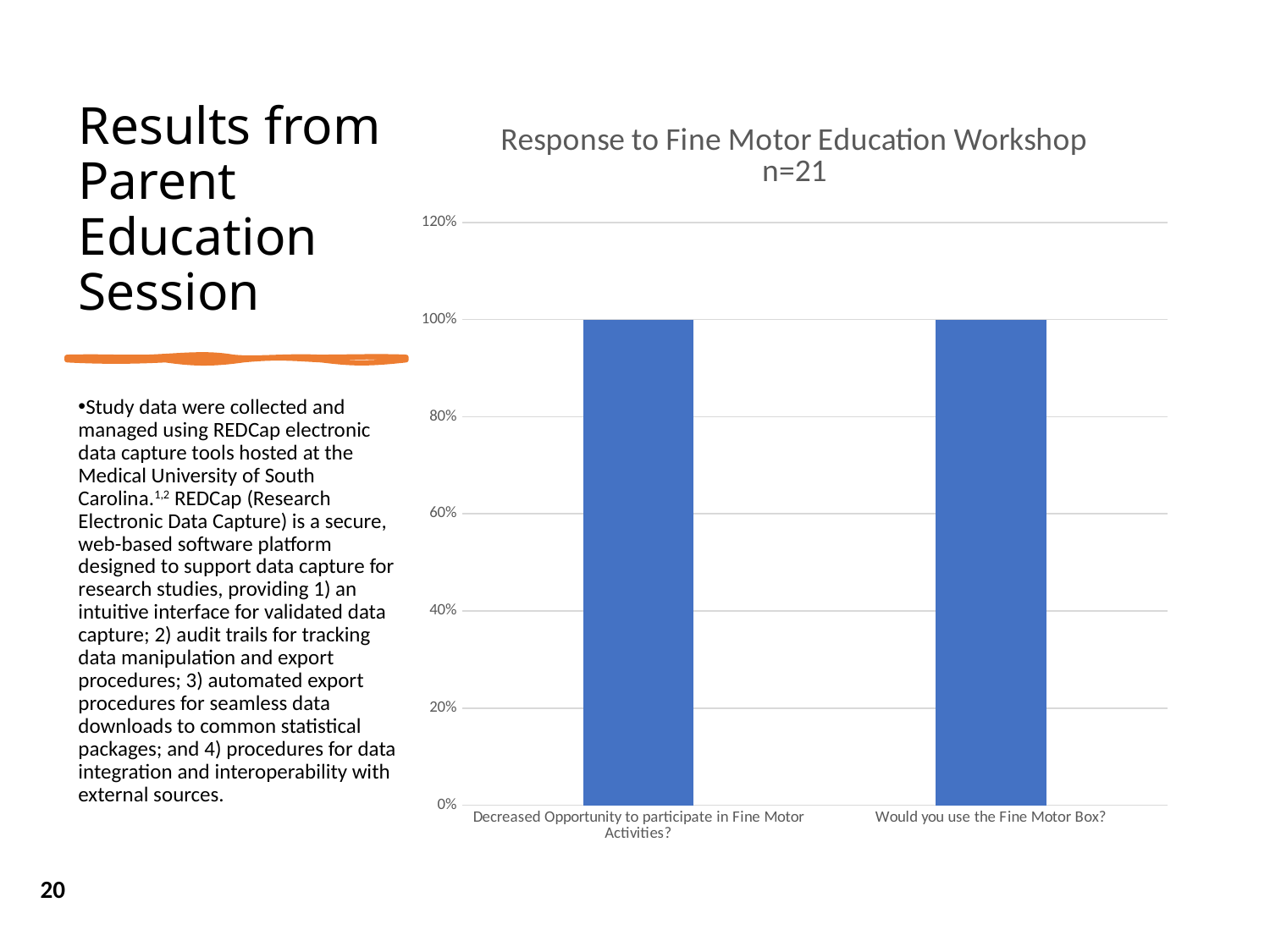
What sample size (n) is stated in the chart title? n=21 What is the highest value shown on the chart's y axis? 120% What kind of chart is shown on the slide? bar chart Is the value for "Decreased Opportunity to participate in Fine Motor Activities?" greater or less than 60%? greater Is the value for "Would you use the Fine Motor Box?" greater or less than 80%? greater What is the value for "Decreased Opportunity to participate in Fine Motor Activities?"? 100% What is the value for "Would you use the Fine Motor Box?"? 100% What is the difference between the values for "Decreased Opportunity to participate in Fine Motor Activities?" and "Would you use the Fine Motor Box?"? 0% What is the title of the chart? Response to Fine Motor Education Workshop n=21 How many categories are shown on the x axis of the chart? 2